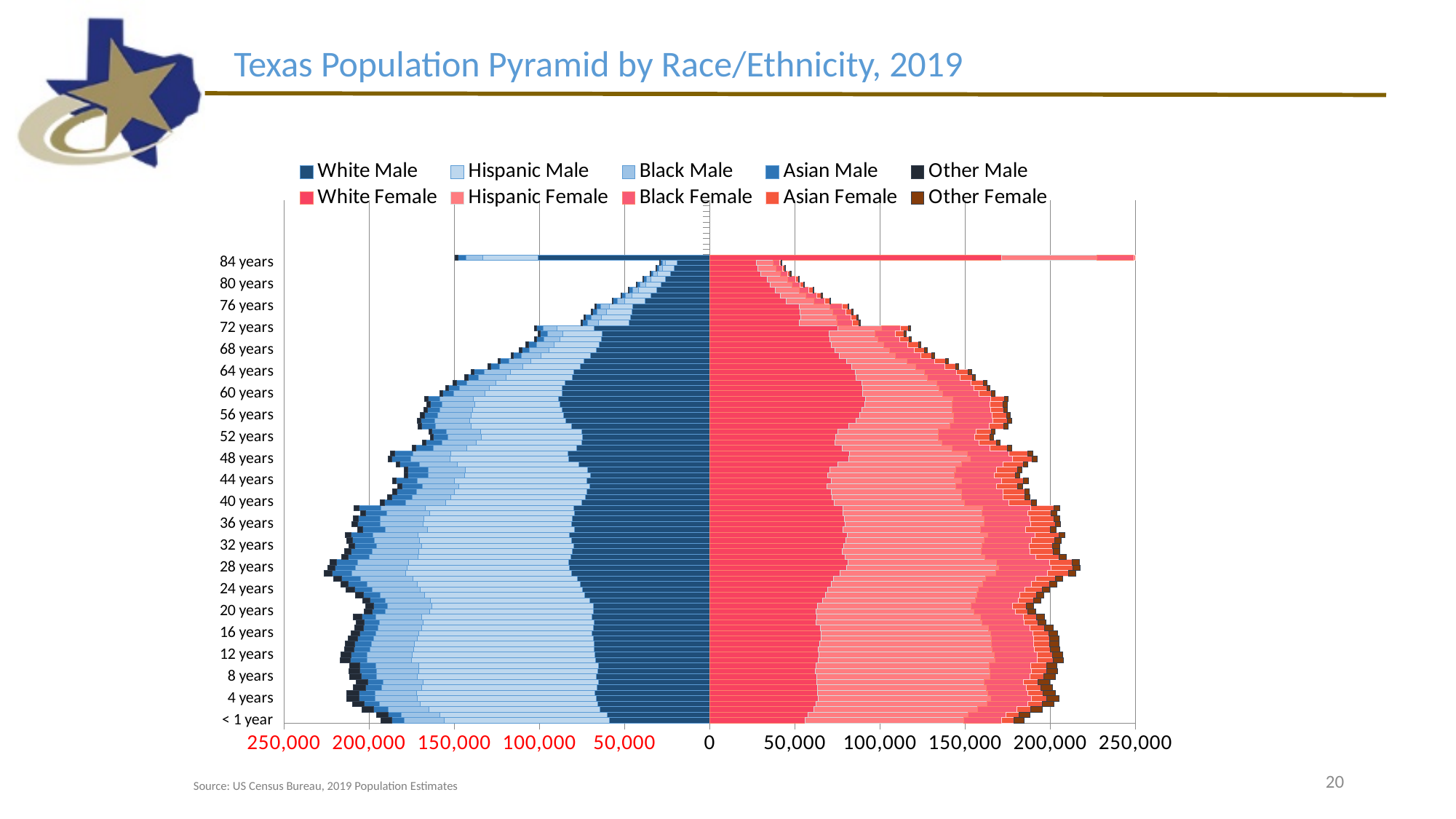
Is the total female bar for 60 years greater or less than 150,000? greater What kind of chart is shown on the slide? Stacked bar chart (population pyramid) Is the total male bar for 76 years greater or less than 100,000? less How many age labels are shown on the vertical axis? 22 Is the total male bar for 80 years greater or less than 50,000? less What is the title of the chart on the slide? Texas Population Pyramid by Race/Ethnicity, 2019 How many series does the legend list? 10 Which series is shown in dark navy on the left side of the pyramid? White Male Which is larger at 84 years, the total male bar or the total female bar? Female